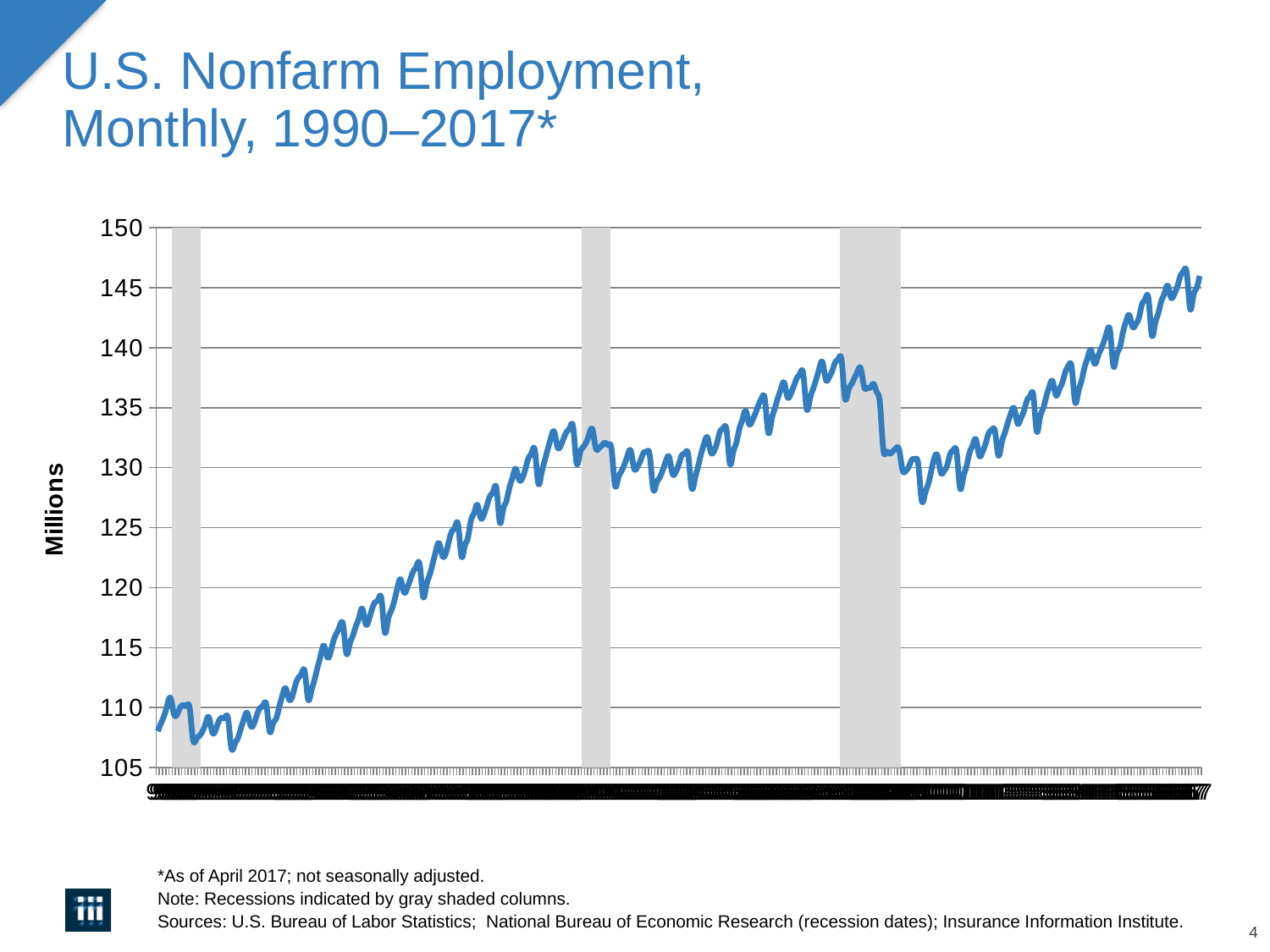
Is the value at the far left of the line greater or less than 115? less Does the line ever reach 150 on the y axis? No Is the value at the far right of the line greater or less than 140? greater What kind of chart is shown on the slide? line chart How many gray shaded recession columns are shown on the chart? 3 What is the label on the y axis? Millions Overall, do the values rise or fall from the left of the x axis to the right? rise What is the title of the chart? U.S. Nonfarm Employment, Monthly, 1990–2017*